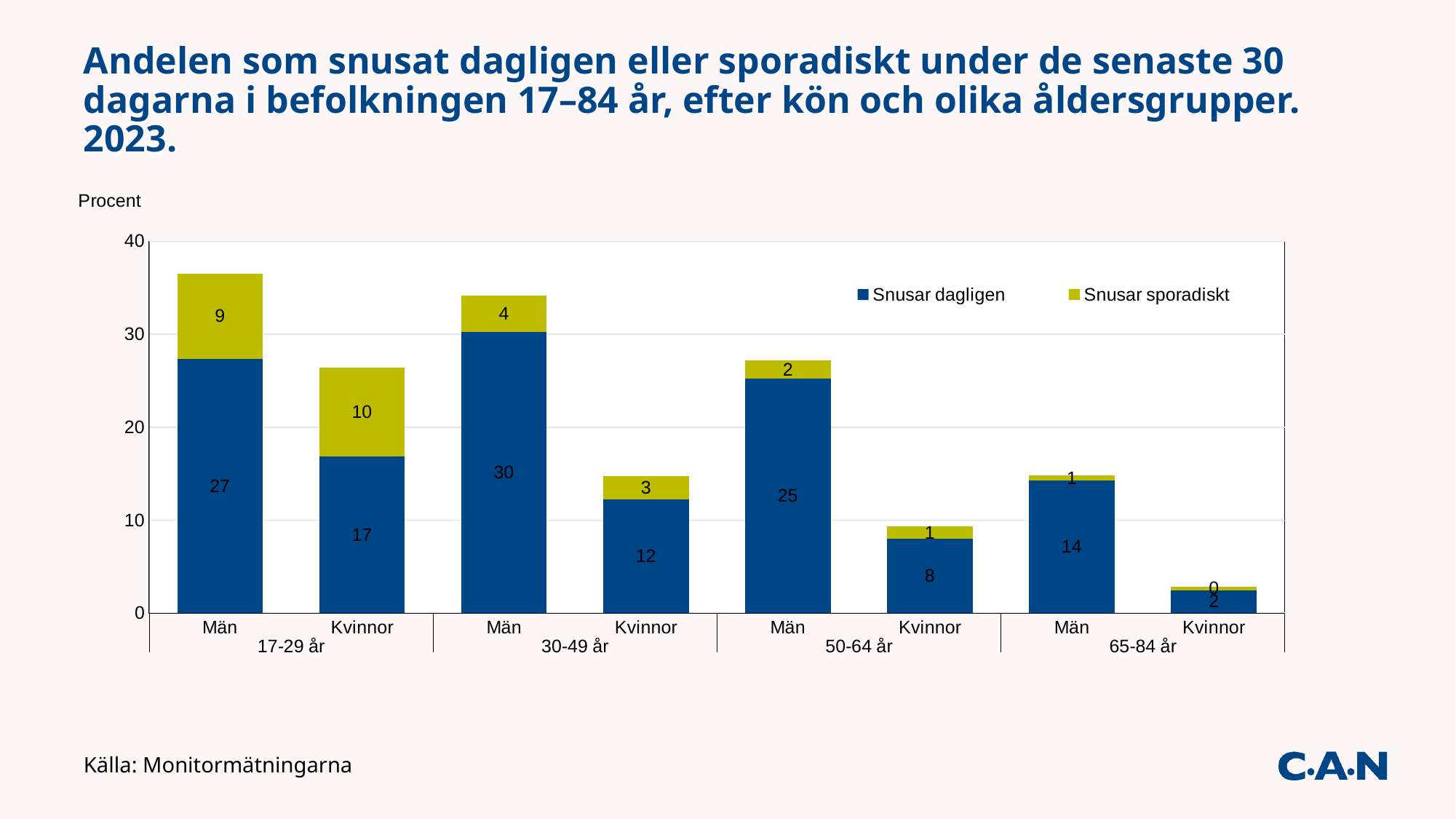
Which is larger: Snusar sporadiskt for Män 17-29 år or Snusar sporadiskt for Kvinnor 17-29 år? Kvinnor 17-29 år What is the difference between the Snusar dagligen values for Män and Kvinnor aged 50-64 år? 17 Is the total stacked bar for Män aged 17-29 år greater or less than 30? greater What is the value for Snusar dagligen among Kvinnor aged 65-84 år? 2 Which group has the lowest value for Snusar sporadiskt? Kvinnor 65-84 år What is the value for Snusar dagligen among Män aged 30-49 år? 30 How many bars are plotted in the chart? 8 Which group has the highest value for Snusar dagligen? Män 30-49 år What is the value for Snusar sporadiskt among Kvinnor aged 17-29 år? 10 What kind of chart is shown on the slide? Stacked bar chart How many series does the legend list? 2 What is the total of the stacked bar for Kvinnor aged 50-64 år? 9